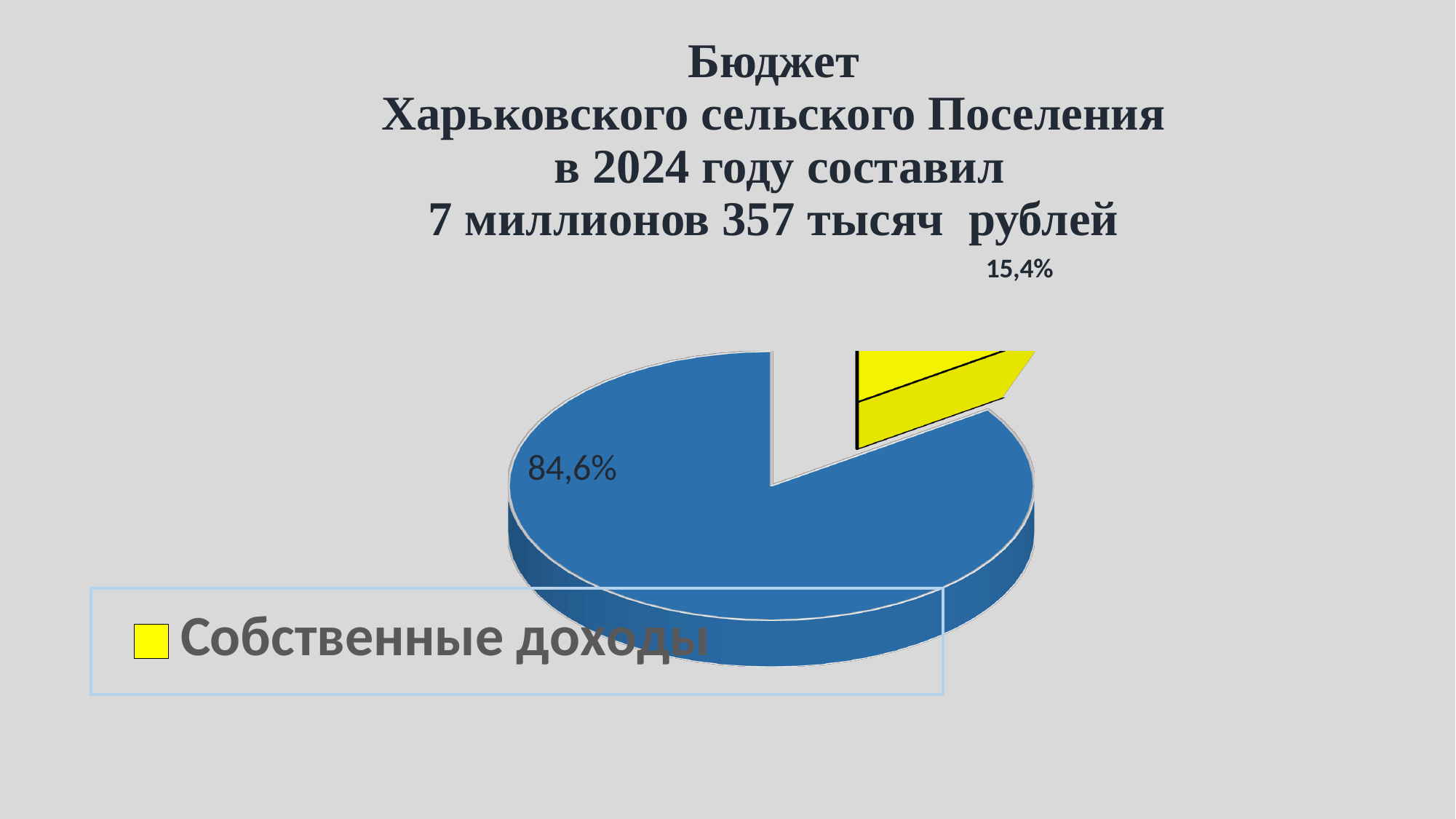
According to the slide title, what was the budget of Харьковское сельское Поселение in 2024? 7 миллионов 357 тысяч рублей What is the value printed on the yellow slice labelled Собственные доходы? 15,4% What is the difference in percentage points between the blue slice (84,6%) and the yellow slice (15,4%)? 69,2 What colour is the slice labelled Собственные доходы in the legend? yellow What kind of chart is shown on the slide? pie chart Which is larger: the blue slice or the yellow Собственные доходы slice? the blue slice Which slice of the pie is the largest? the blue slice (84,6%) Which slice of the pie is the smallest? Собственные доходы (yellow, 15,4%) How many entries does the legend list? 1 What share of the pie does the blue slice represent? 84,6% What share of the pie does the yellow slice (Собственные доходы) represent? 15,4% How many slices does the pie chart have? 2